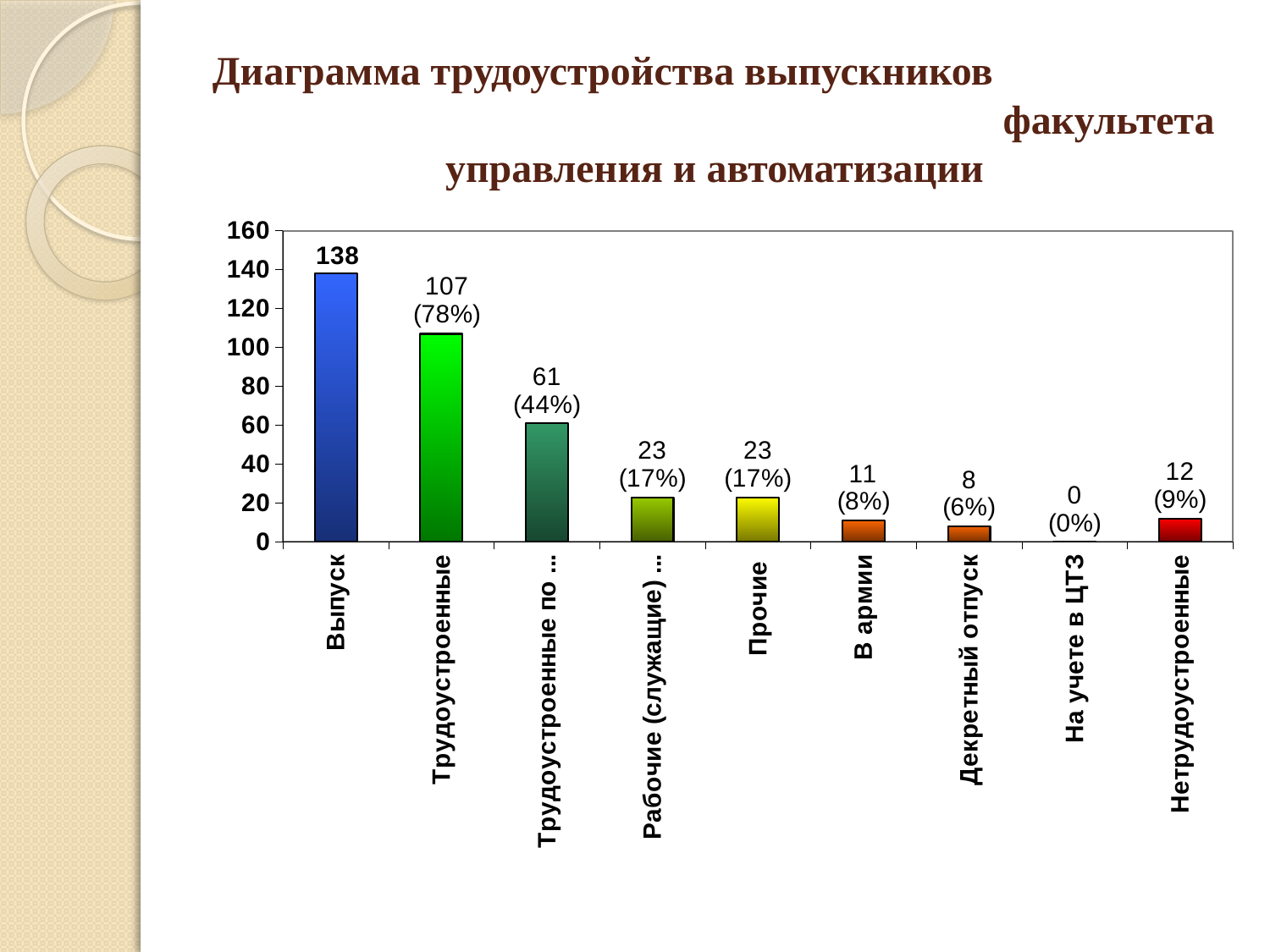
What is the value for Трудоустроенные? 107 What is the difference between the values for Выпуск and Трудоустроенные? 31 What is the value for Нетрудоустроенные? 12 What percentage is shown for В армии? 8% What is the value for Выпуск? 138 Which category has the lowest value? На учете в ЦТЗ What kind of chart is shown on the slide? Bar chart Which is larger, the value for Декретный отпуск or the value for Нетрудоустроенные? Нетрудоустроенные How many categories are shown on the x axis? 9 What is the value for На учете в ЦТЗ? 0 What colour is the bar for Нетрудоустроенные? Red Which category has the highest value? Выпуск